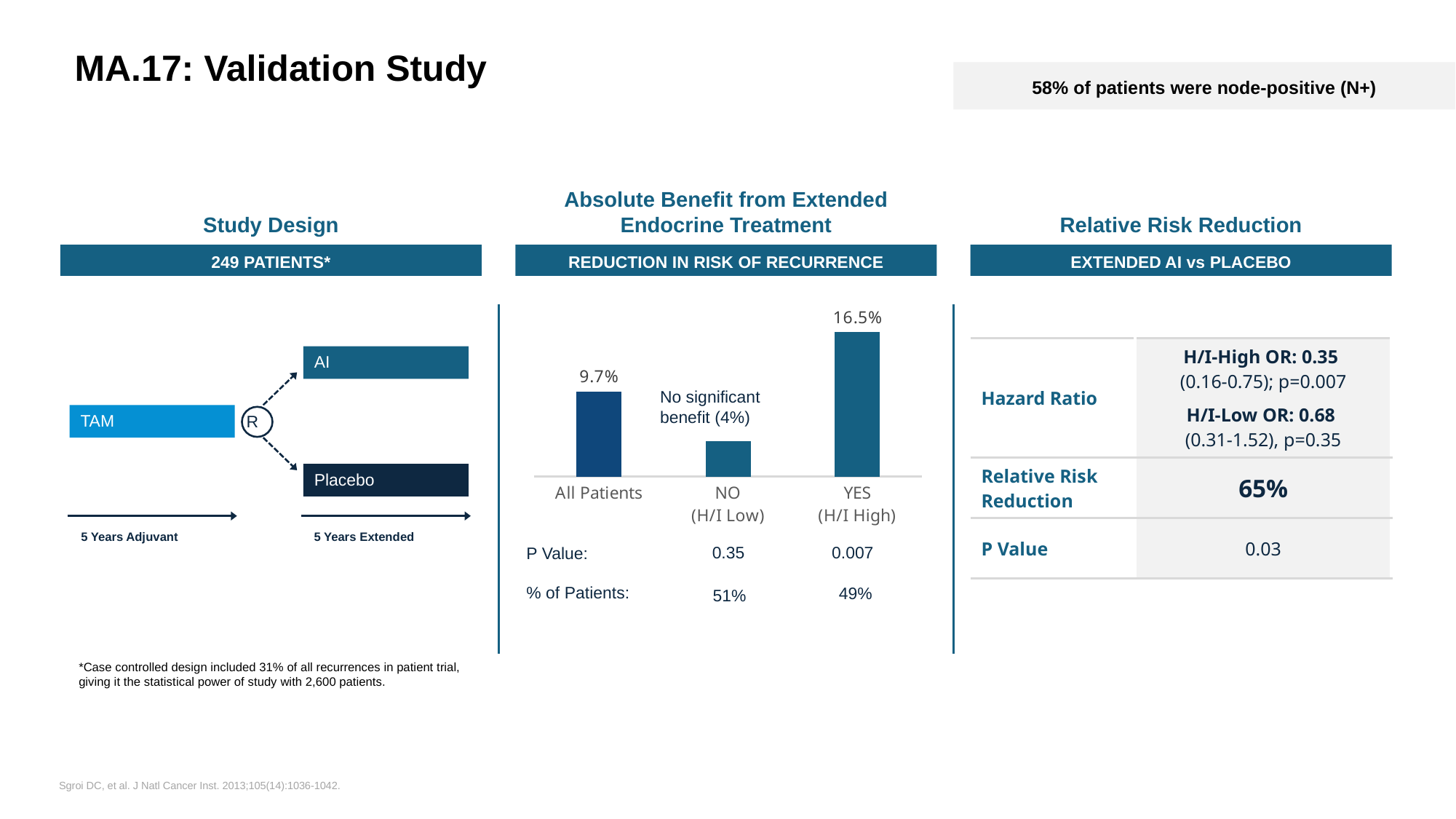
In the Absolute Benefit chart, what is the value for YES (H/I High)? 16.5% In the Absolute Benefit chart, what P value is listed under YES (H/I High)? 0.007 In the Absolute Benefit chart, which category has the highest value? YES (H/I High) In the Absolute Benefit chart, what is the difference between YES (H/I High) and NO (H/I Low)? 12.5% How many bars are in the Absolute Benefit chart? 3 What is the subtitle banner above the Absolute Benefit chart? REDUCTION IN RISK OF RECURRENCE In the Absolute Benefit chart, what is the value for NO (H/I Low)? 4% In the Absolute Benefit chart, what is the difference between YES (H/I High) and All Patients? 6.8% In the Absolute Benefit chart, which category has the lowest value? NO (H/I Low) In the Absolute Benefit chart, what is the value for All Patients? 9.7% In the Absolute Benefit chart, which is larger, All Patients or NO (H/I Low)? All Patients What kind of chart is shown under "Absolute Benefit from Extended Endocrine Treatment"? bar chart